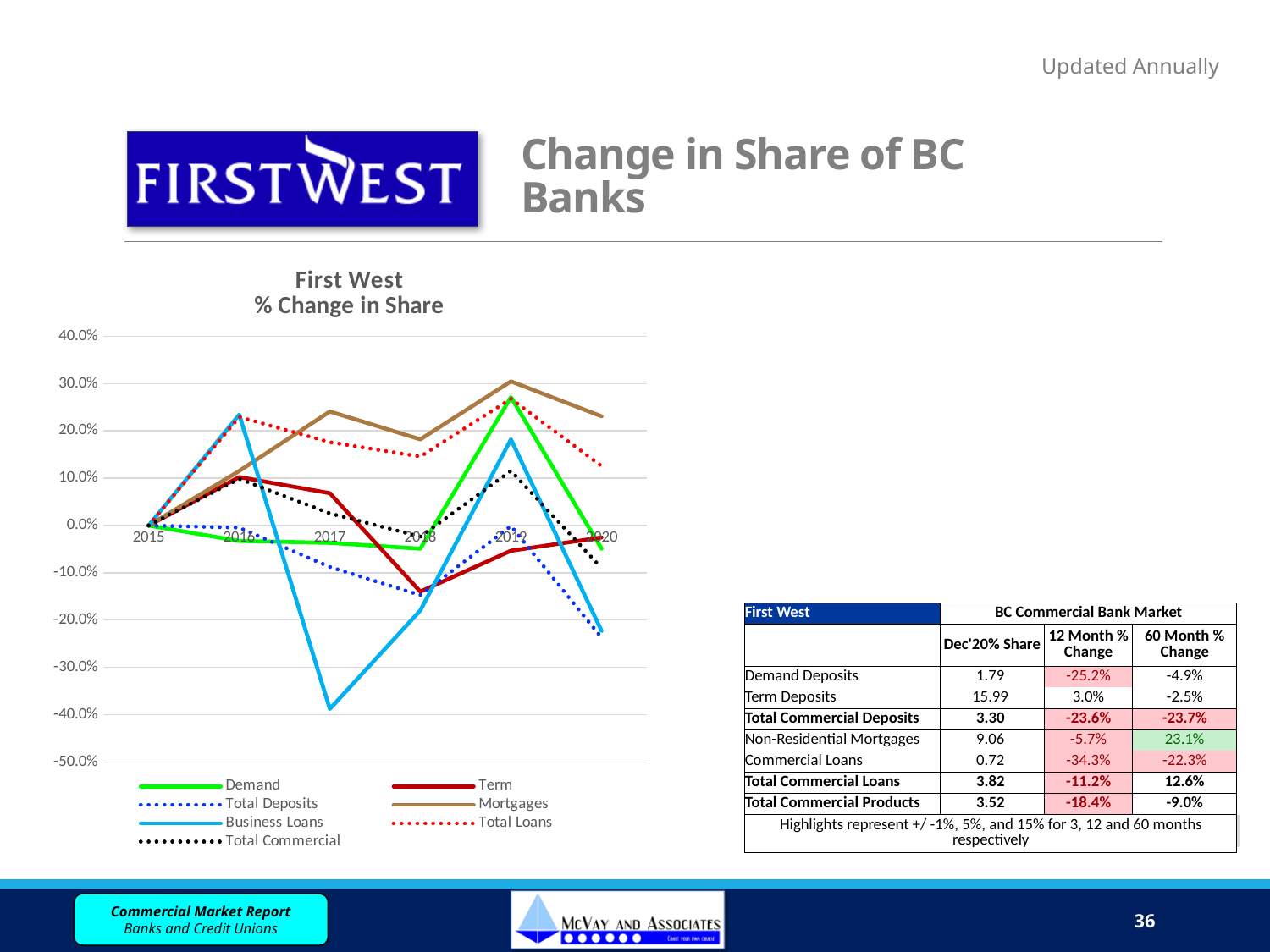
Is the value for Term in 2018 greater or less than -10.0%? less Does the Mortgages series rise or fall from 2015 to 2017? rise What kind of chart is shown on the slide? line chart Is the value for Total Deposits in 2020 greater or less than -10.0%? less What is the title of the chart? First West % Change in Share Is the value for Business Loans in 2017 greater or less than -30.0%? less How many series does the legend of the First West % Change in Share chart list? 7 Does the Business Loans series rise or fall from 2016 to 2017? fall How many years are plotted along the x axis of the chart? 6 Which series has the lowest value in 2017? Business Loans In 2020, which is larger: the value for Mortgages or the value for Term? Mortgages